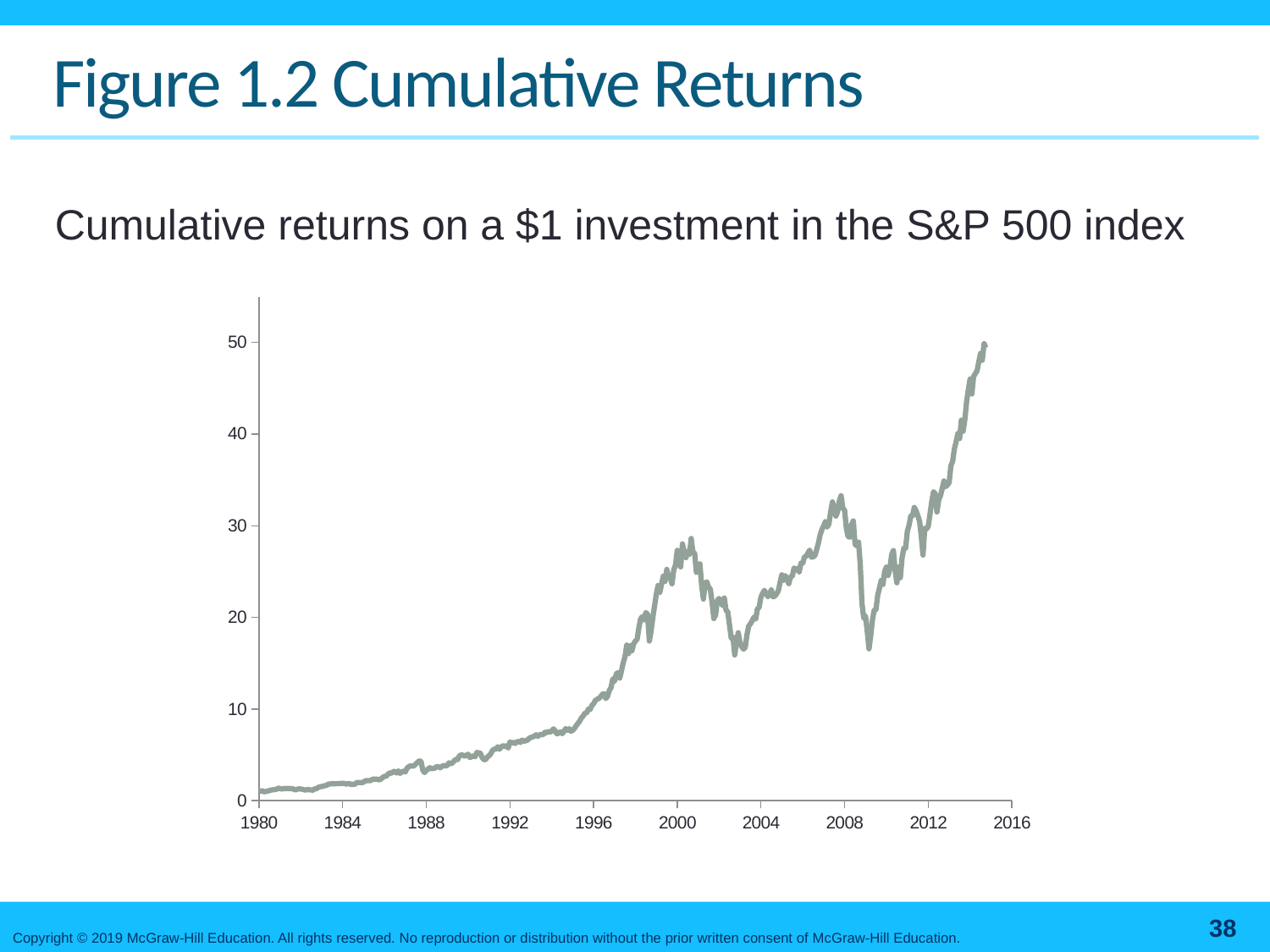
Is the value of the cumulative return in 1990 greater or less than 10? less What is the highest tick value shown on the y axis? 50 Is the value of the cumulative return in 2004 greater or less than 30? less Is the value of the cumulative return in 1984 greater or less than 10? less How many lines are plotted on the chart? 1 What kind of chart is shown on the slide? line chart Overall, does the cumulative return rise or fall from 1980 to the end of the series? rise What is the first year labelled on the x axis? 1980